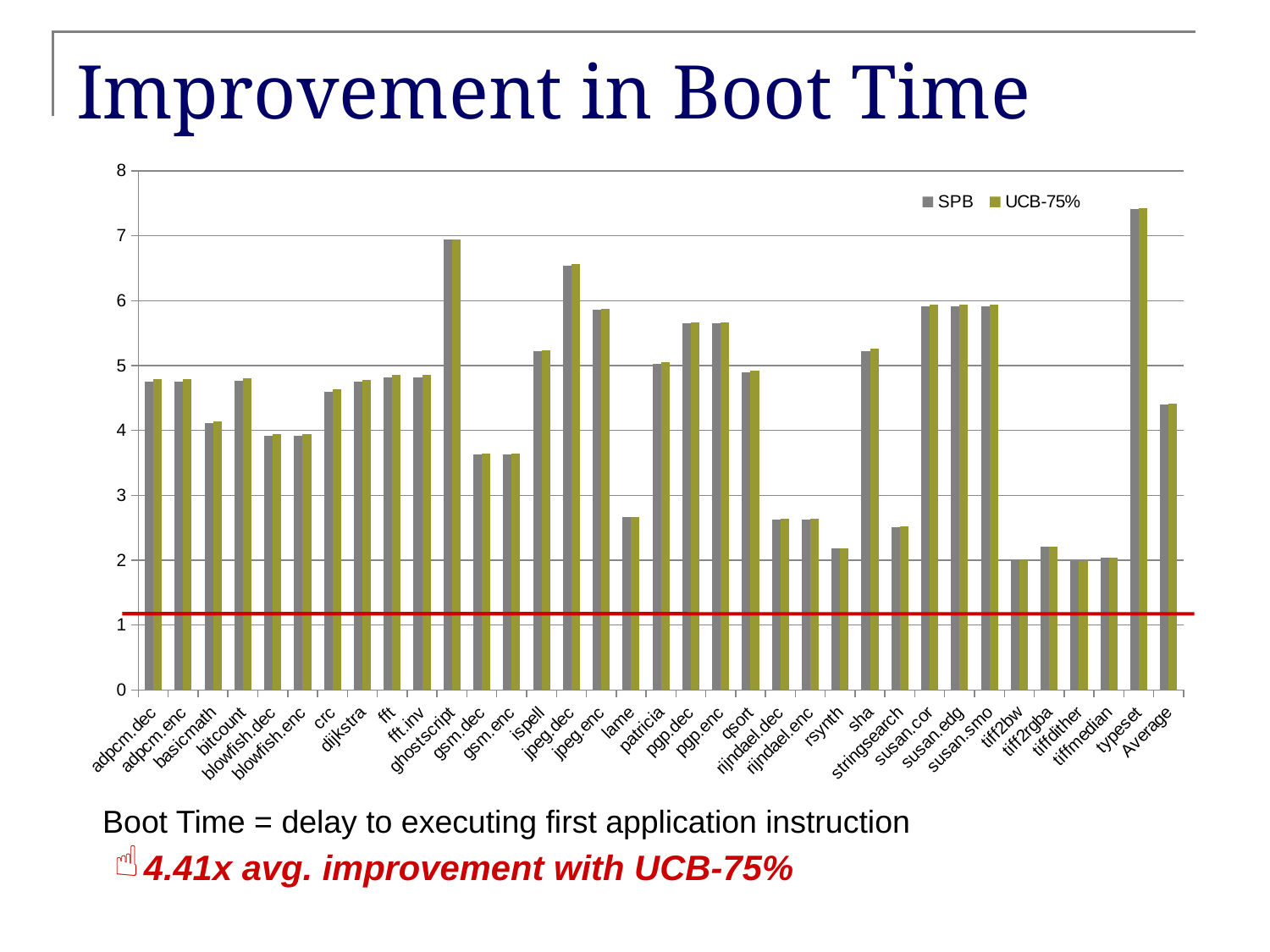
Is the UCB-75% value for stringsearch greater or less than 3? less Which category has the highest bars? typeset What are the two series named in the legend? SPB and UCB-75% Which has the larger SPB value, lame or rsynth? lame Is the SPB value for Average greater or less than 4? greater How many series does the legend list? 2 Is the SPB value for ghostscript greater or less than 6? greater Which has the larger SPB value, ghostscript or jpeg.dec? ghostscript What kind of chart is shown on the slide? bar chart How many categories are shown along the x axis? 35